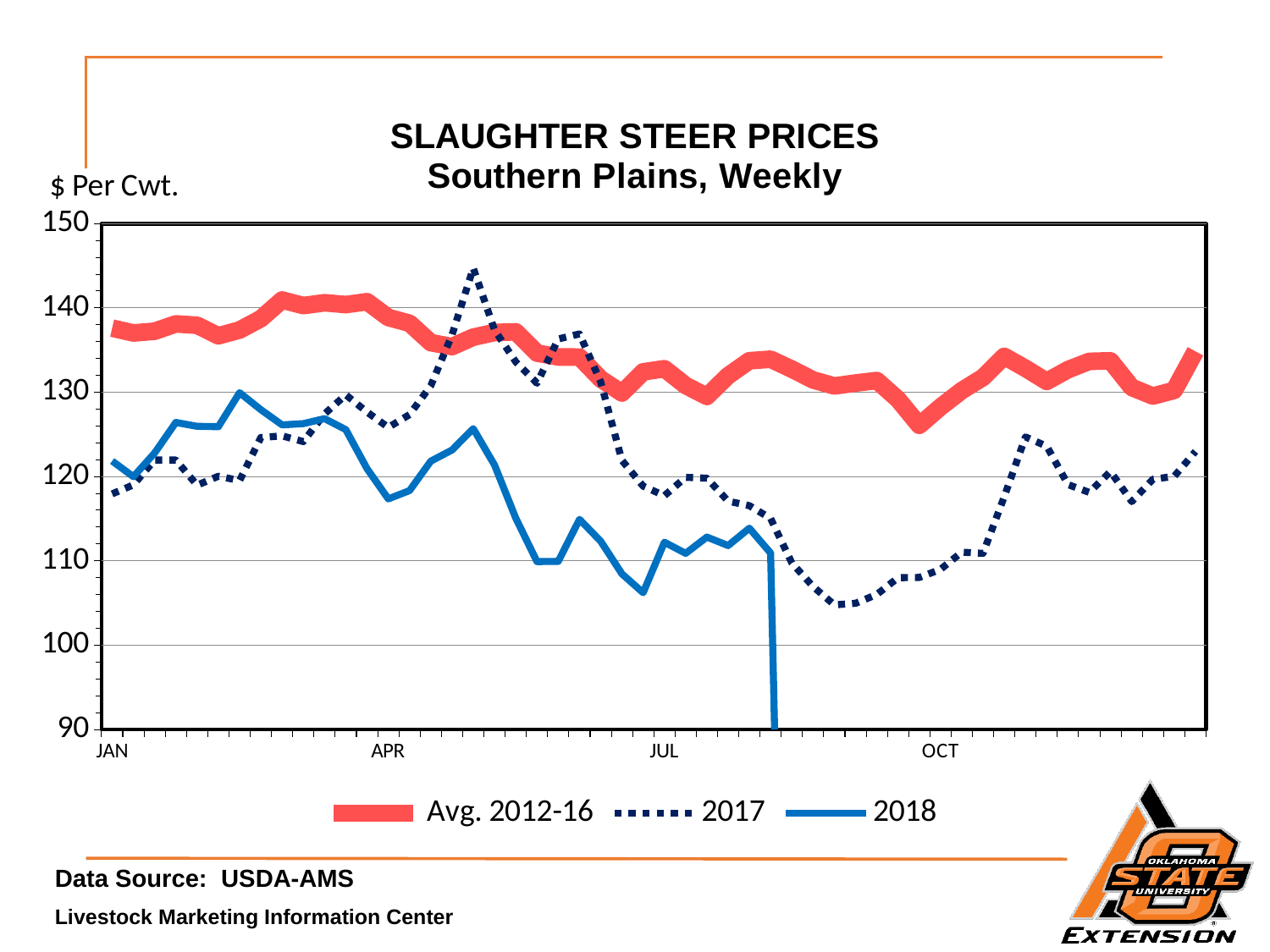
Is the value of the Avg. 2012-16 series in January greater or less than 130? greater In January, which is higher: the Avg. 2012-16 series or the 2018 series? Avg. 2012-16 How many series does the legend list? 3 Is the peak value of the 2017 series (around late April/May) greater or less than 140? greater Is the value of the 2018 series in April greater or less than 120? less Does the 2018 series rise or fall from April to July? fall What is the title of the chart? SLAUGHTER STEER PRICES Southern Plains, Weekly In July, which is higher: the 2017 series or the 2018 series? 2017 What kind of chart is shown on the slide? line chart What unit is shown on the y axis label? $ Per Cwt.